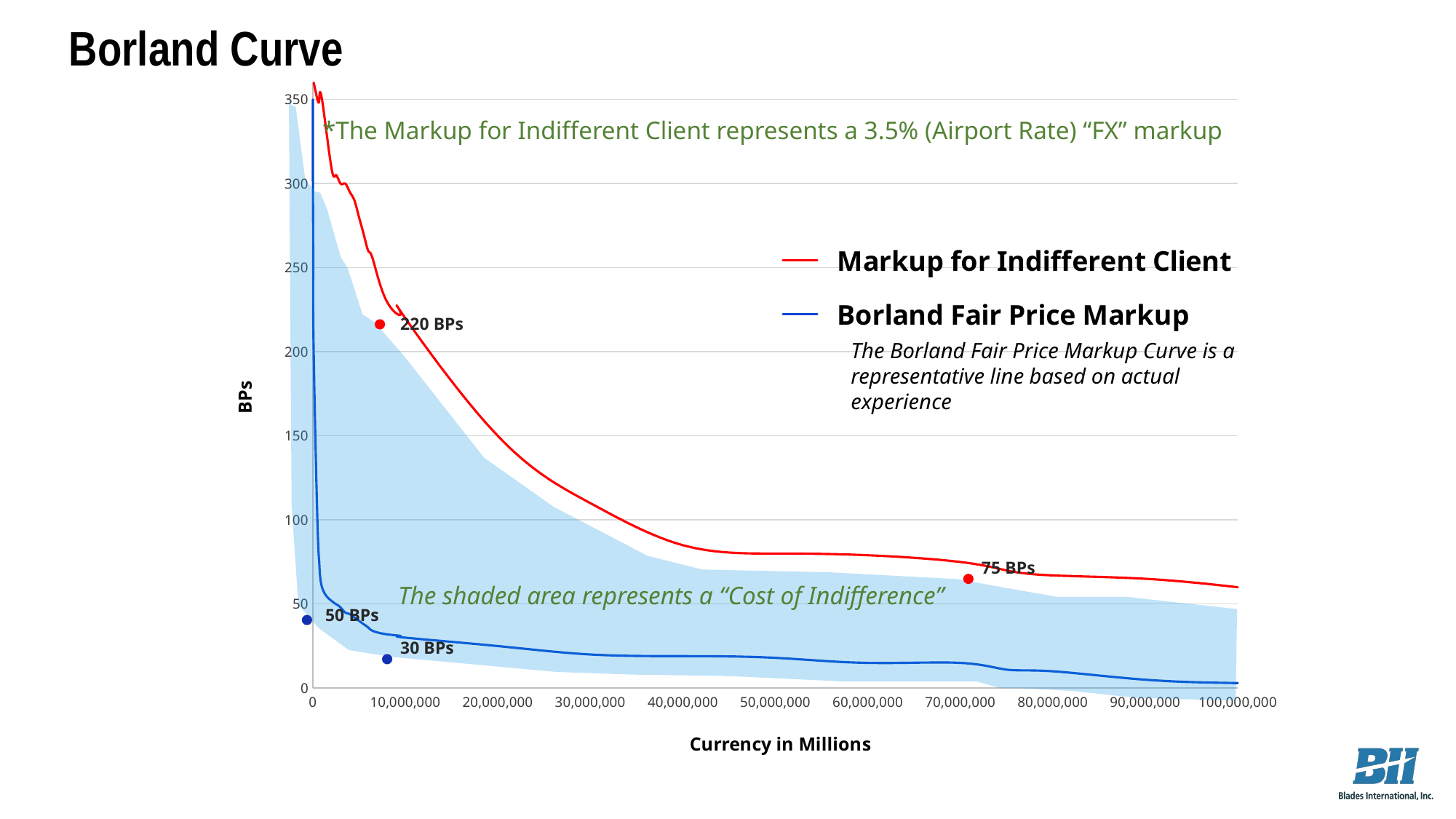
How many series does the legend list? 2 What is the label of the x axis? Currency in Millions What kind of chart is shown on the slide? Line chart What is the lower labeled value on the Borland Fair Price Markup line? 30 BPs What is the title of the chart? Borland Curve What is the difference between the two labeled values on the Borland Fair Price Markup line (50 BPs and 30 BPs)? 20 BPs Do the values of the Markup for Indifferent Client line rise or fall as Currency in Millions increases? Fall What is the labeled value on the Markup for Indifferent Client line near 70,000,000? 75 BPs Which series has the higher values across the x axis, Markup for Indifferent Client or Borland Fair Price Markup? Markup for Indifferent Client What is the higher labeled value on the Markup for Indifferent Client line? 220 BPs What is the labeled value on the Borland Fair Price Markup line at the far left, near 0? 50 BPs What is the difference between the two labeled values on the Markup for Indifferent Client line (220 BPs and 75 BPs)? 145 BPs